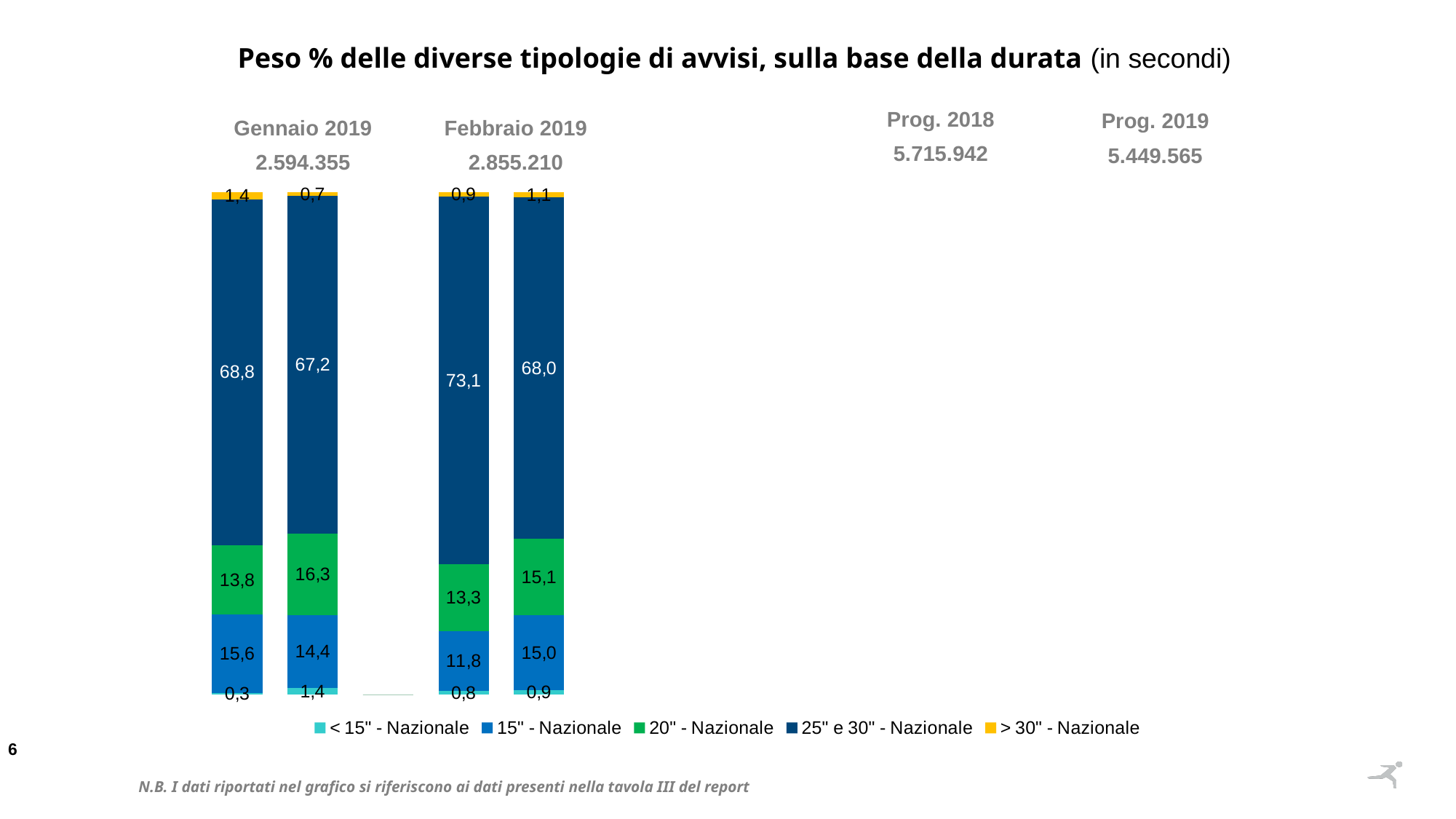
Which bar has the lowest value for the 15'' - Nazionale segment? The left bar under Febbraio 2019 (11,8) Is the > 30'' - Nazionale value larger in the left bar under Gennaio 2019 or in the right bar under Gennaio 2019? The left bar (1,4) What total figure is shown under the Febbraio 2019 heading? 2.855.210 Which bar has the highest value for the 25'' e 30'' - Nazionale segment? The left bar under Febbraio 2019 (73,1) What is the value of the 20'' - Nazionale segment in the right bar under Febbraio 2019? 15,1 What is the value of the 25'' e 30'' - Nazionale segment in the left bar under Gennaio 2019? 68,8 What kind of chart is shown on the slide? Stacked bar chart What is the difference between the 20'' - Nazionale values of the two bars under Gennaio 2019? 2,5 What is the value of the 15'' - Nazionale segment in the left bar under Febbraio 2019? 11,8 How many series does the legend list? 5 What is the value of the < 15'' - Nazionale segment in the right bar under Gennaio 2019? 1,4 How many bars are plotted in the chart? 4